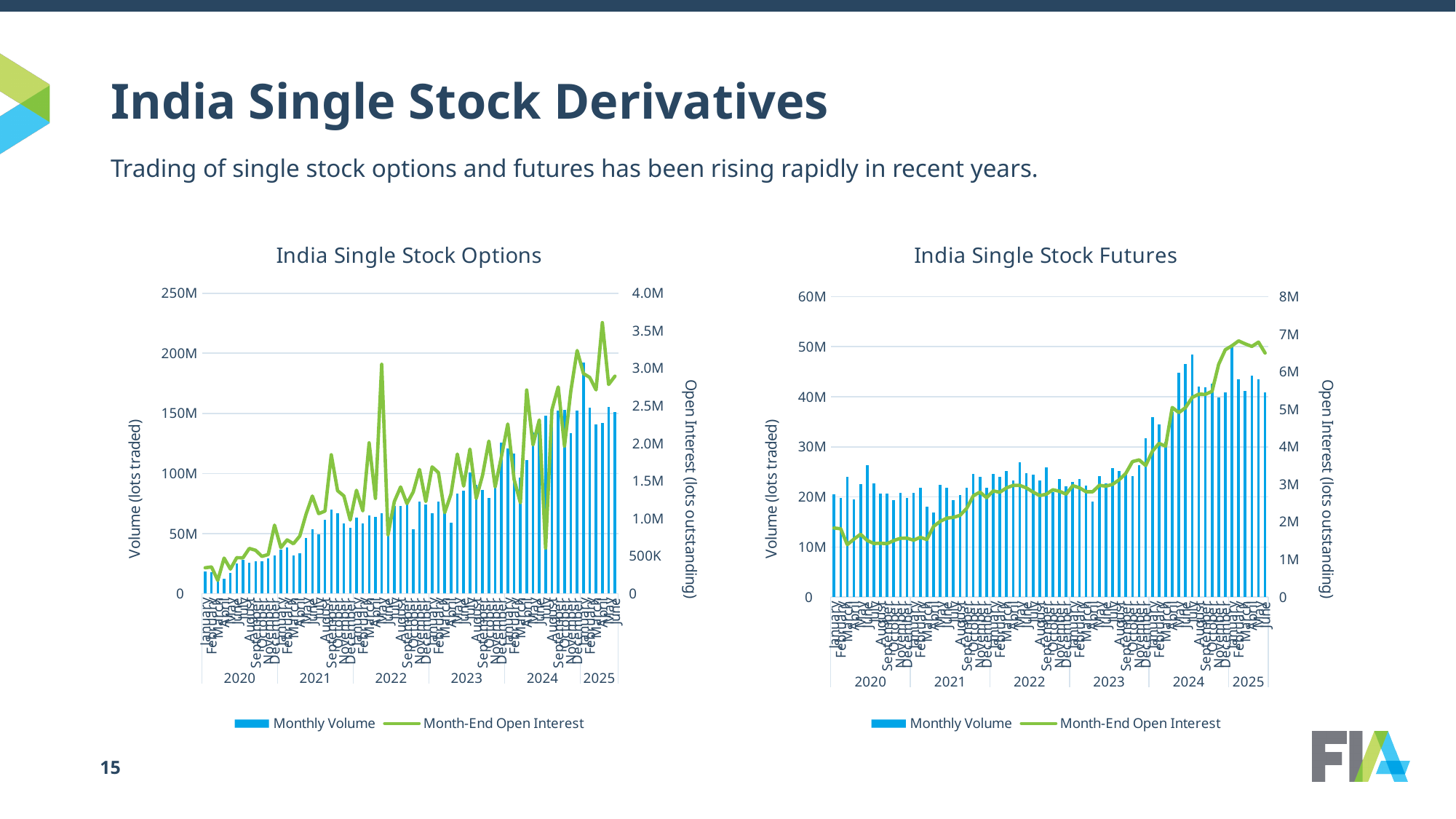
On the India Single Stock Futures chart, which is higher: the Month-End Open Interest at the start of 2020 or at the end of the series in 2025? 2025 On the India Single Stock Futures chart, is the tallest Monthly Volume bar greater or less than 40M? greater What kind of chart is the India Single Stock Options chart? A combined bar and line chart On the India Single Stock Options chart, is the first Monthly Volume bar in 2020 greater or less than 50M? less How many years are labelled along the x axis of the India Single Stock Futures chart? 6 What is the label of the right-hand axis on the India Single Stock Futures chart? Open Interest (lots outstanding) On the India Single Stock Futures chart, is the peak of the Month-End Open Interest line greater or less than 6M? greater How many series does the legend of the India Single Stock Futures chart list? 2 What are the two legend entries on the India Single Stock Options chart? Monthly Volume and Month-End Open Interest On the India Single Stock Options chart, does the Month-End Open Interest line generally rise or fall from 2020 to 2025? rise On the India Single Stock Futures chart, do the Monthly Volume bars generally rise or fall from 2020 to 2025? rise